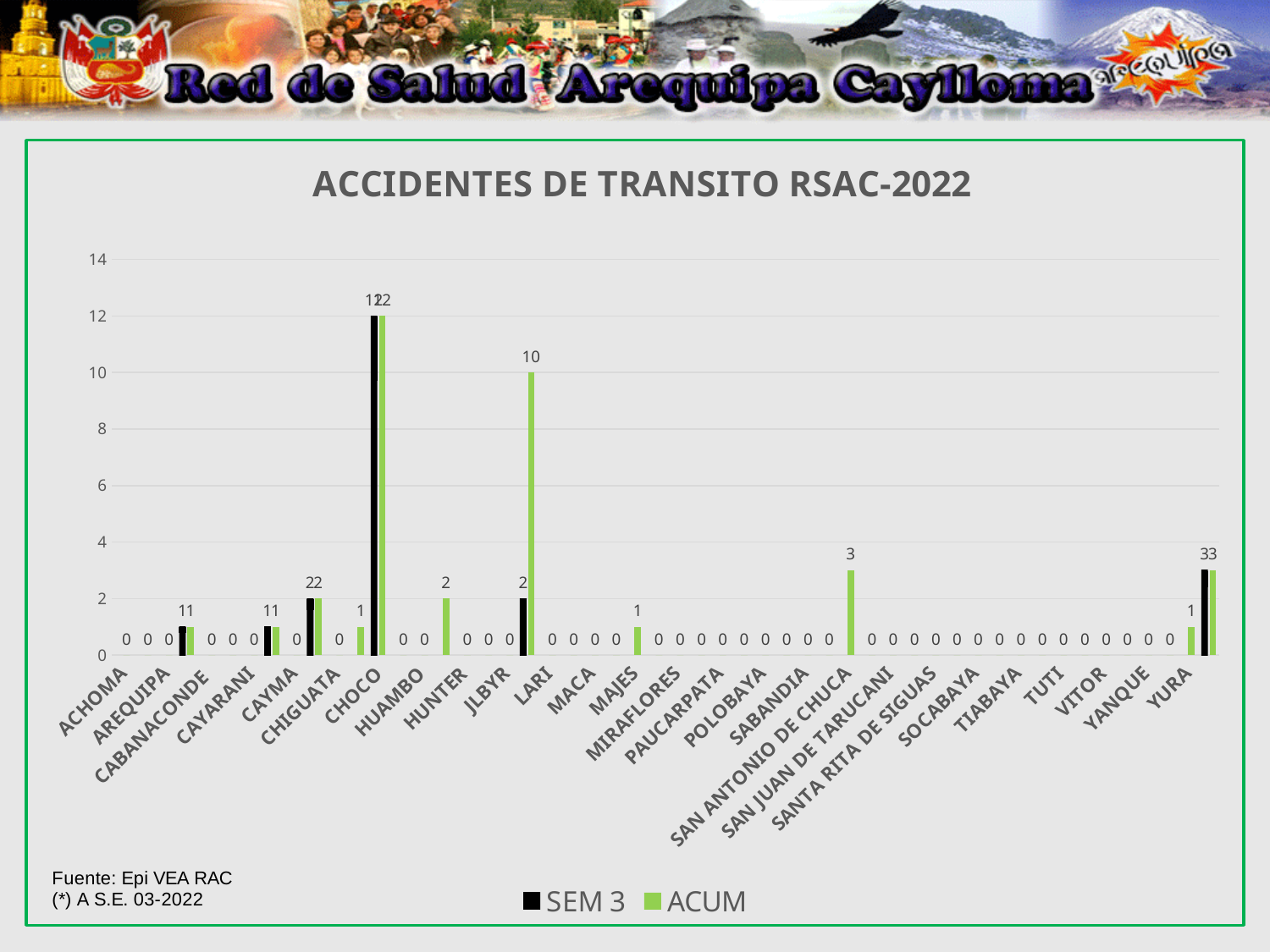
What is the title of the chart? ACCIDENTES DE TRANSITO RSAC-2022 How many series does the legend list? 2 What type of chart is shown on the slide? bar chart What is the ACUM value for JLBYR? 0 What is the ACUM value for CHOCO? 12 Which is larger, the ACUM value for CHOCO or for JLBYR? CHOCO Which category has the highest ACUM value? CHOCO What are the two series named in the legend? SEM 3 and ACUM What is the difference between the ACUM value and the SEM 3 value for JLBYR? 0 What is the ACUM value for HUNTER? 0 What is the ACUM value for SAN ANTONIO DE CHUCA? 3